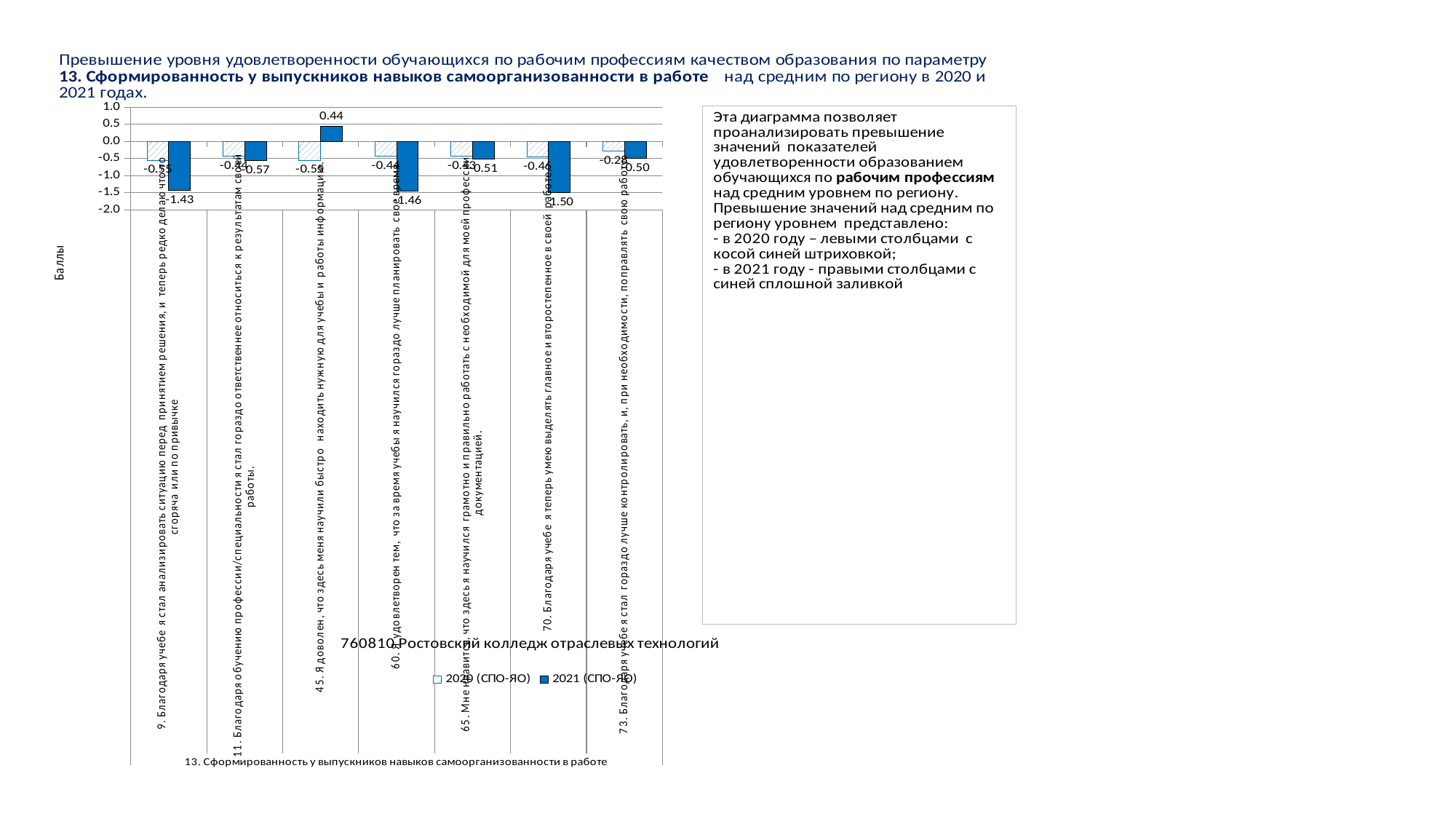
How many categories (survey statements) are plotted on the chart? 7 Which statement has the lowest 2021 (СПО-ЯО) value? 70. Благодаря учебе я теперь умею выделять главное и второстепенное в своей работе What kind of chart is shown on the slide? bar chart How many series does the chart legend list? 2 Which is larger: the 2021 (СПО-ЯО) value for statement 9 or for statement 60? statement 9 What is the 2020 (СПО-ЯО) value for statement 73 (Благодаря учебе я стал гораздо лучше контролировать, и, при необходимости, поправлять свою работу)? -0.28 Which statement has the highest 2021 (СПО-ЯО) value? 45. Я доволен, что здесь меня научили быстро находить нужную для учебы и работы информацию For statement 45, what is the difference between the 2021 (СПО-ЯО) value and the 2020 (СПО-ЯО) value? 0.99 What is the 2021 (СПО-ЯО) value for statement 9 (Благодаря учебе я стал анализировать ситуацию перед принятием решения)? -1.43 What is the 2021 (СПО-ЯО) value for statement 45 (Я доволен, что здесь меня научили быстро находить нужную для учебы и работы информацию)? 0.44 What is the 2021 (СПО-ЯО) value for statement 70 (Благодаря учебе я теперь умею выделять главное и второстепенное в своей работе)? -1.50